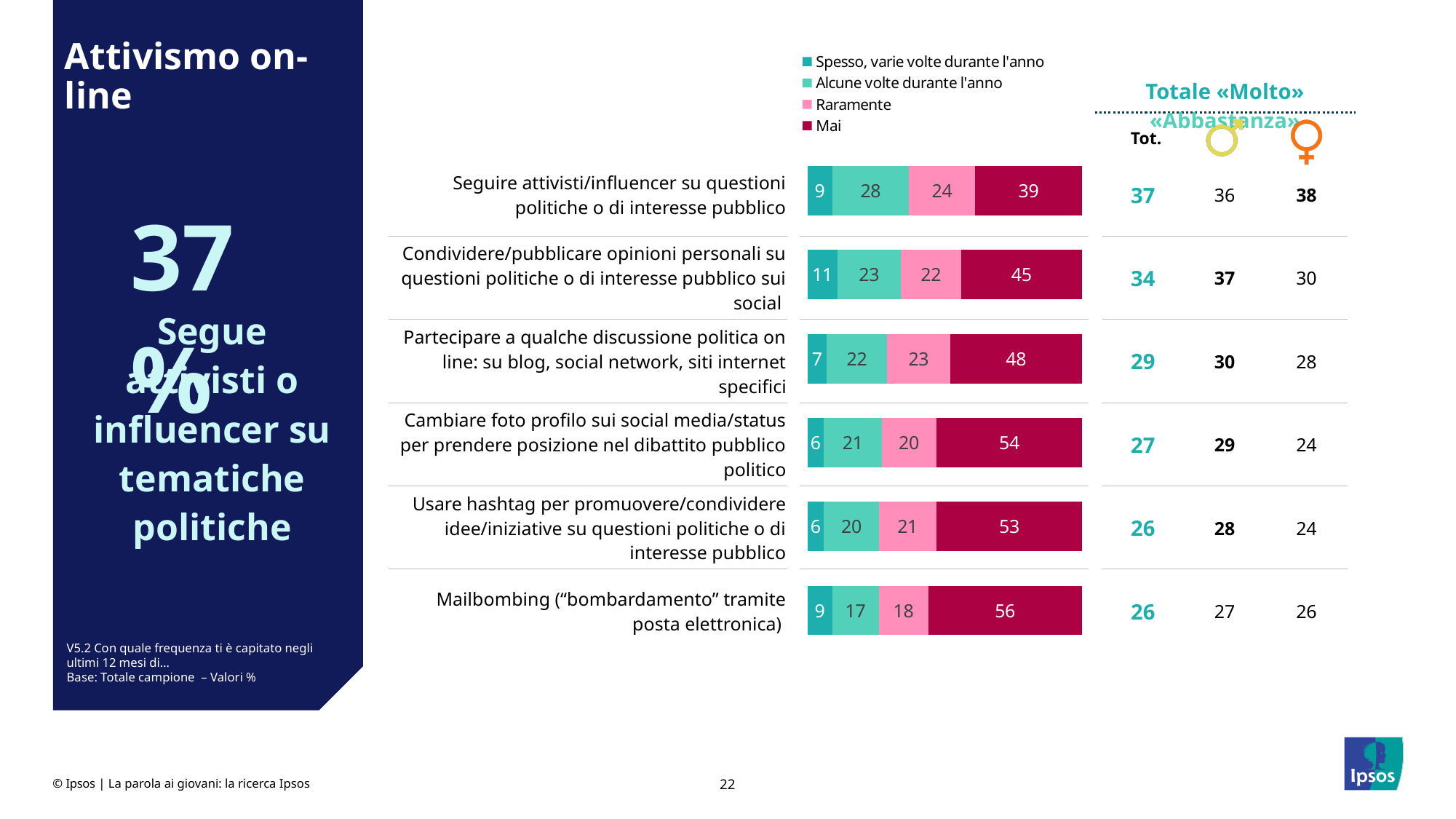
Which category has the highest value for "Mai"? Mailbombing ("bombardamento" tramite posta elettronica) What is the total of the stacked bar for "Usare hashtag per promuovere/condividere idee/iniziative su questioni politiche o di interesse pubblico"? 100 Which is larger: the "Alcune volte durante l'anno" value for "Seguire attivisti/influencer su questioni politiche o di interesse pubblico" or for "Partecipare a qualche discussione politica on line: su blog, social network, siti internet specifici"? Seguire attivisti/influencer su questioni politiche o di interesse pubblico Which category has the lowest value for "Alcune volte durante l'anno"? Mailbombing ("bombardamento" tramite posta elettronica) What is the difference between the "Mai" values for "Cambiare foto profilo sui social media/status per prendere posizione nel dibattito pubblico politico" and "Seguire attivisti/influencer su questioni politiche o di interesse pubblico"? 15 How many categories (activities) are plotted in the chart? 6 What is the value of "Raramente" for "Seguire attivisti/influencer su questioni politiche o di interesse pubblico"? 24 What is the value of "Mai" for "Mailbombing ("bombardamento" tramite posta elettronica)"? 56 Which legend entry is shown in dark red/magenta? Mai What kind of chart is shown on the slide? stacked bar chart How many series does the legend list? 4 What is the value of "Spesso, varie volte durante l'anno" for "Condividere/pubblicare opinioni personali su questioni politiche o di interesse pubblico sui social"? 11